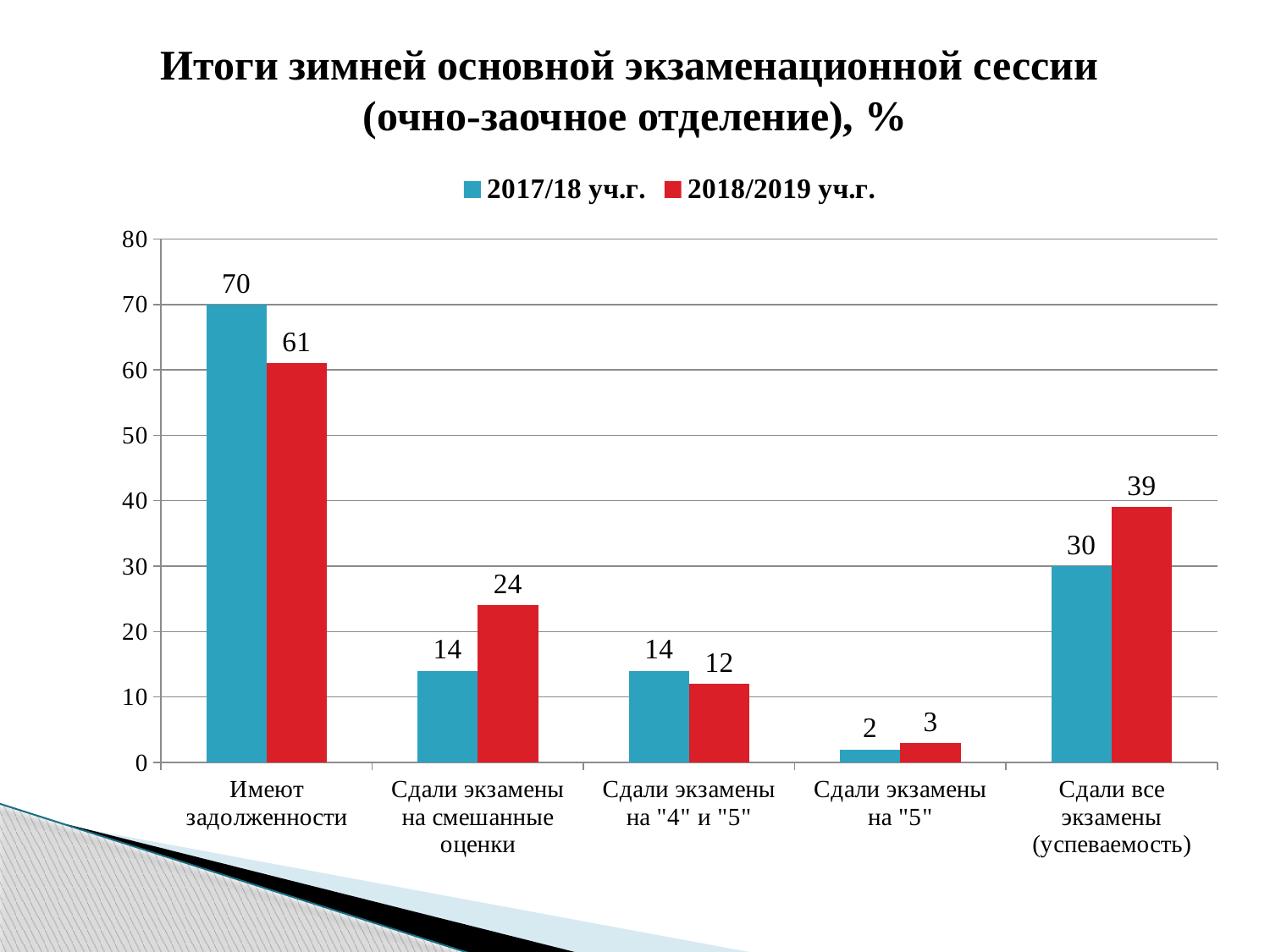
For "Сдали экзамены на "4" и "5"", which series has the larger value, 2017/18 уч.г. or 2018/2019 уч.г.? 2017/18 уч.г. Which colour represents the 2018/2019 уч.г. series? Red How many categories are shown on the x axis? 5 What is the difference between the 2017/18 уч.г. and 2018/2019 уч.г. values for "Имеют задолженности"? 9 What kind of chart is shown on the slide? Bar chart What is the difference between the 2018/2019 уч.г. and 2017/18 уч.г. values for "Сдали все экзамены (успеваемость)"? 9 What is the value for "Сдали все экзамены (успеваемость)" in the 2018/2019 уч.г. series? 39 How many series does the legend list? 2 What is the value for "Сдали экзамены на смешанные оценки" in the 2018/2019 уч.г. series? 24 What is the value for "Имеют задолженности" in the 2017/18 уч.г. series? 70 Which category has the lowest value in the 2017/18 уч.г. series? Сдали экзамены на "5" Which category has the highest value in the 2018/2019 уч.г. series? Имеют задолженности